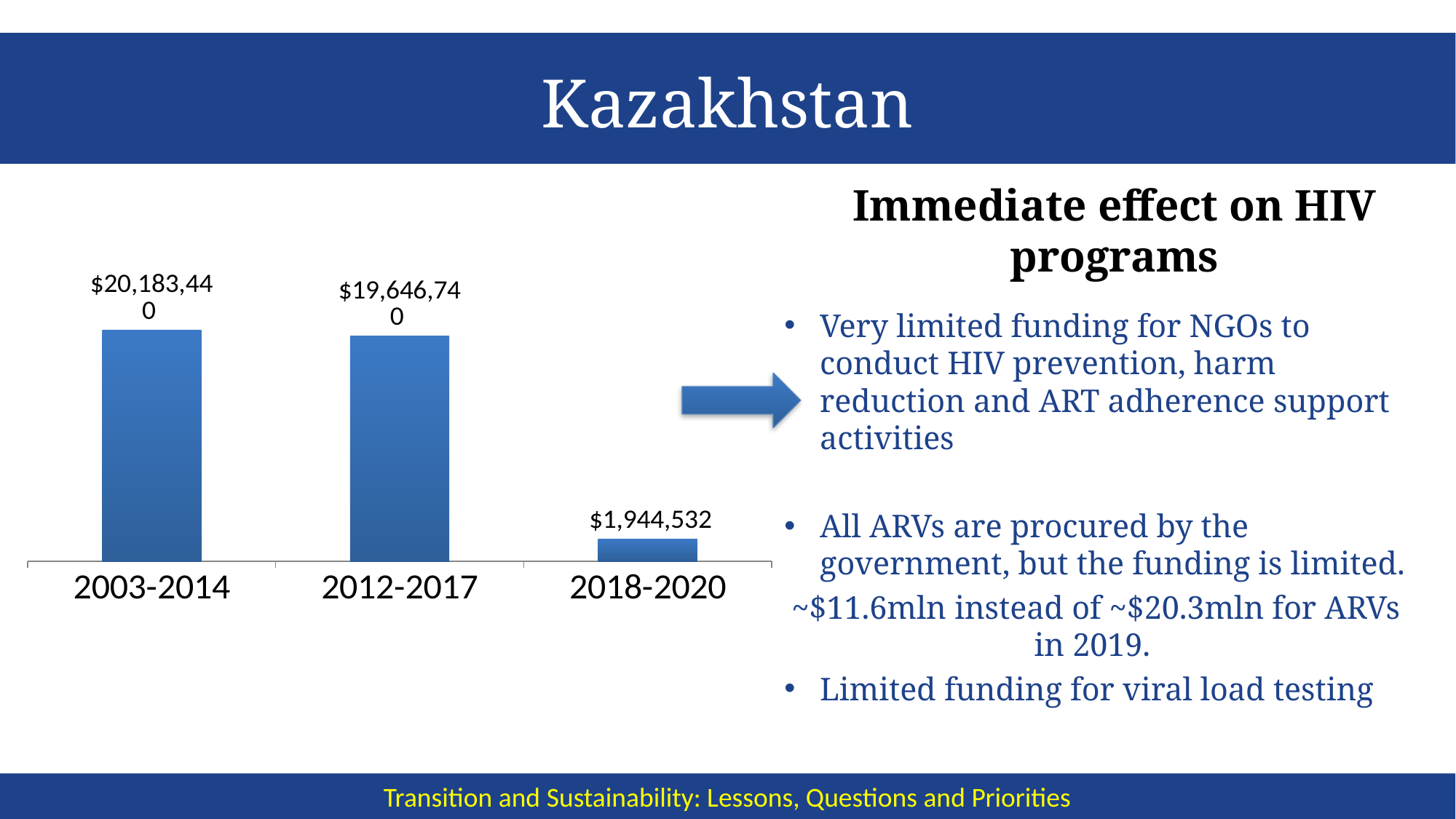
What colour are the bars in the chart? Blue Which period has the lowest value? 2018-2020 What is the difference between the values for 2012-2017 and 2018-2020? $17,702,208 Do the values rise or fall from 2003-2014 to 2018-2020? Fall What is the value shown for 2003-2014? $20,183,440 What kind of chart is shown on the slide? Bar chart Which period has the highest value? 2003-2014 What is the difference between the values for 2003-2014 and 2012-2017? $536,700 How many periods are shown on the chart? 3 What is the value shown for 2018-2020? $1,944,532 Which is larger, the value for 2012-2017 or the value for 2018-2020? 2012-2017 What is the value shown for 2012-2017? $19,646,740